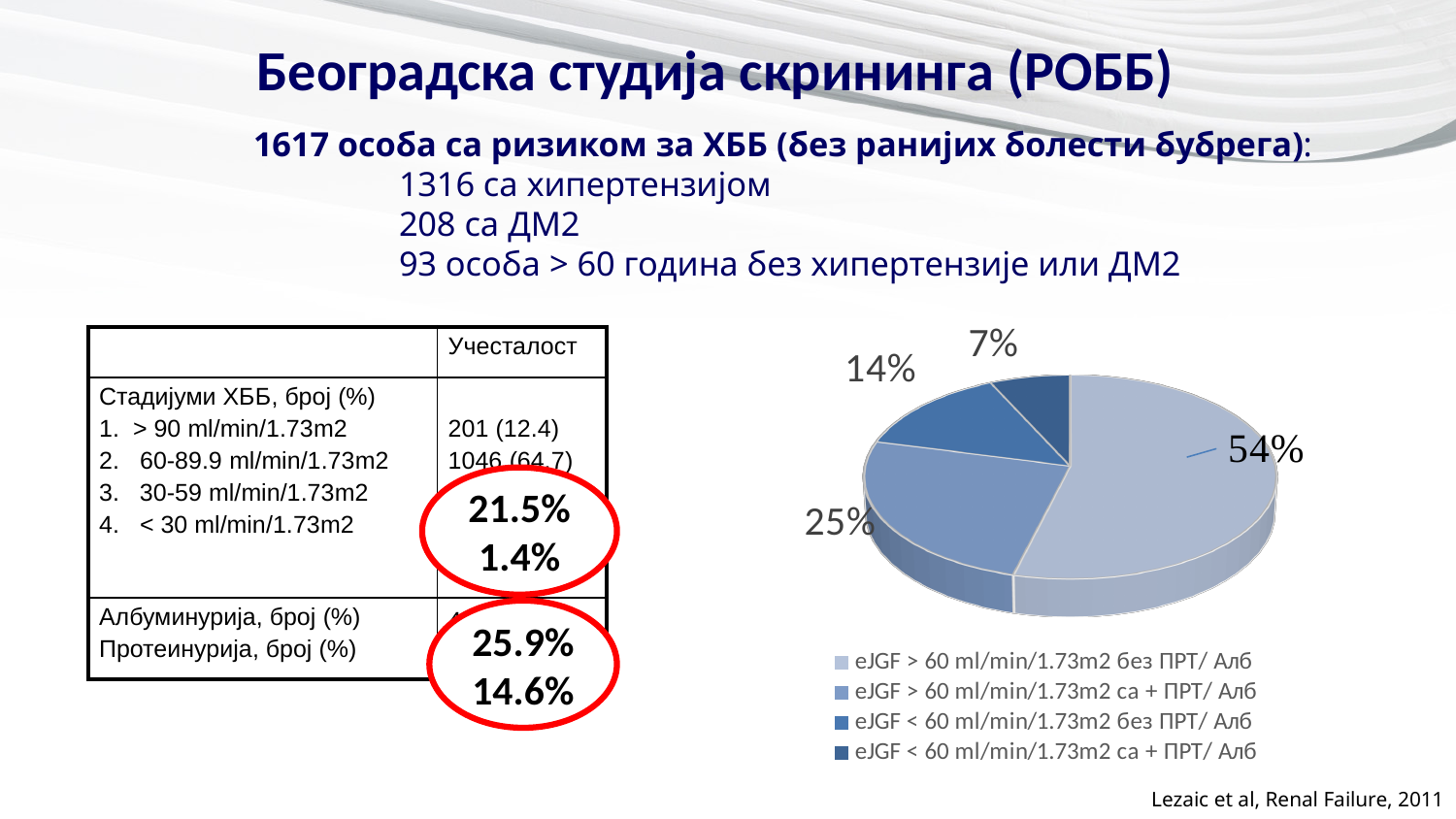
What is the largest share shown in the pie chart? 54% In the pie chart, what is the difference between the 54% slice and the 25% slice? 29% In the pie chart, what share is shown for eJGF > 60 ml/min/1.73m2 без ПРТ/ Алб? 54% In the pie chart, which is larger: the slice for eJGF < 60 ml/min/1.73m2 без ПРТ/ Алб or the slice for eJGF < 60 ml/min/1.73m2 са + ПРТ/ Алб? eJGF < 60 ml/min/1.73m2 без ПРТ/ Алб In the pie chart, what share is shown for eJGF < 60 ml/min/1.73m2 без ПРТ/ Алб? 14% What is the smallest share shown in the pie chart? 7% In the pie chart, what share is shown for eJGF < 60 ml/min/1.73m2 са + ПРТ/ Алб? 7% What kind of chart is shown on the right side of the slide? pie chart In the pie chart, what share is shown for eJGF > 60 ml/min/1.73m2 са + ПРТ/ Алб? 25% How many slices does the pie chart have? 4 How many entries does the pie chart's legend list? 4 Which legend entry in the pie chart is shown with the darkest blue colour? eJGF < 60 ml/min/1.73m2 са + ПРТ/ Алб